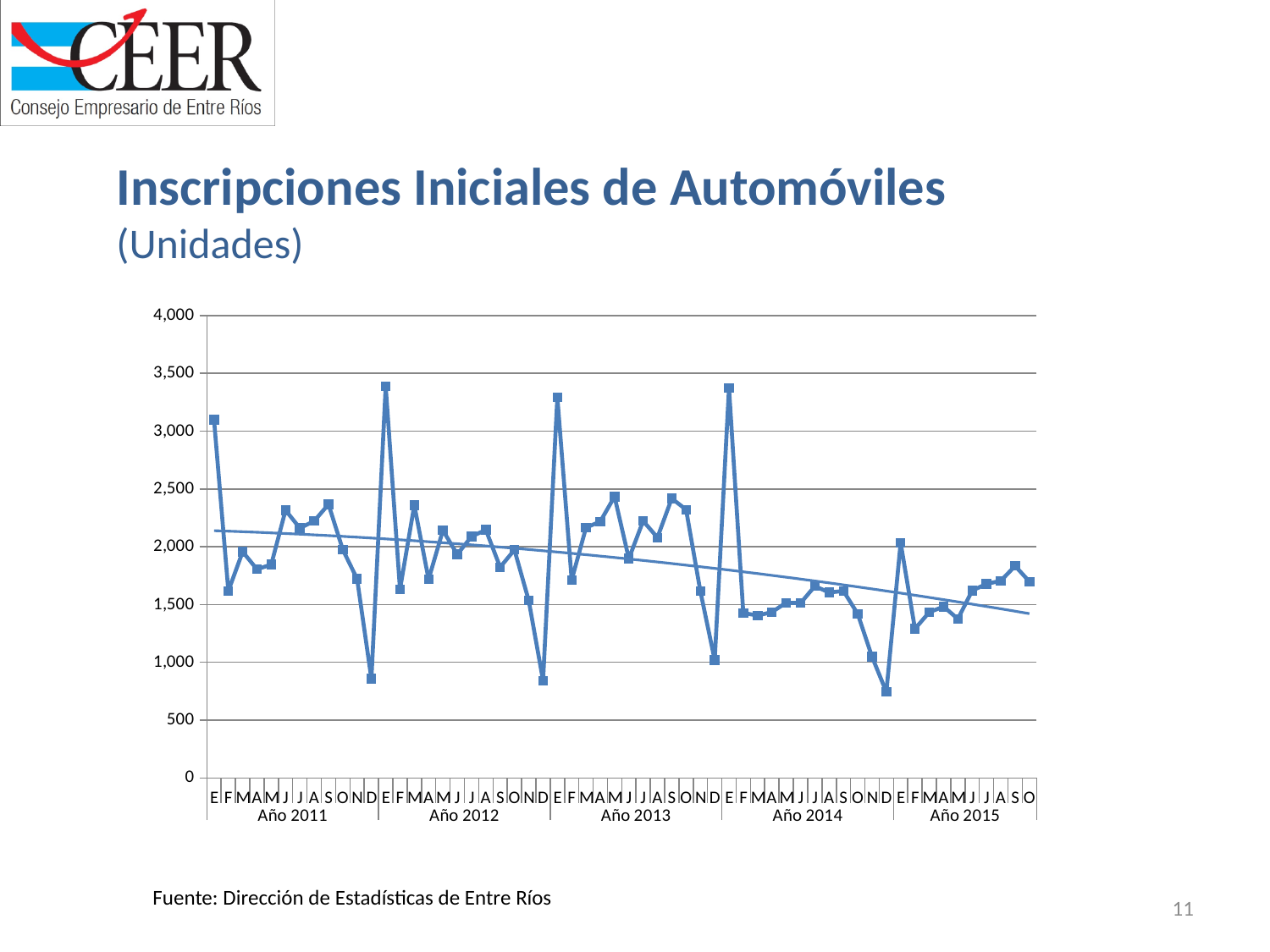
Is the value for O (octubre) of Año 2015 greater or less than 1,500? greater Is the value for E (enero) of Año 2012 greater or less than 3,000? greater Does the straight trend line drawn across the chart rise or fall from Año 2011 to Año 2015? Fall How many years are labeled along the horizontal axis? 5 What kind of chart is shown on the slide? Line chart Which is larger, the value for E (enero) of Año 2011 or E (enero) of Año 2012? E (enero) of Año 2012 Is the value for D (diciembre) of Año 2014 greater or less than 1,000? less What is the title of the chart? Inscripciones Iniciales de Automóviles How many months are plotted for Año 2015? 10 What is the highest value shown on the vertical axis? 4,000